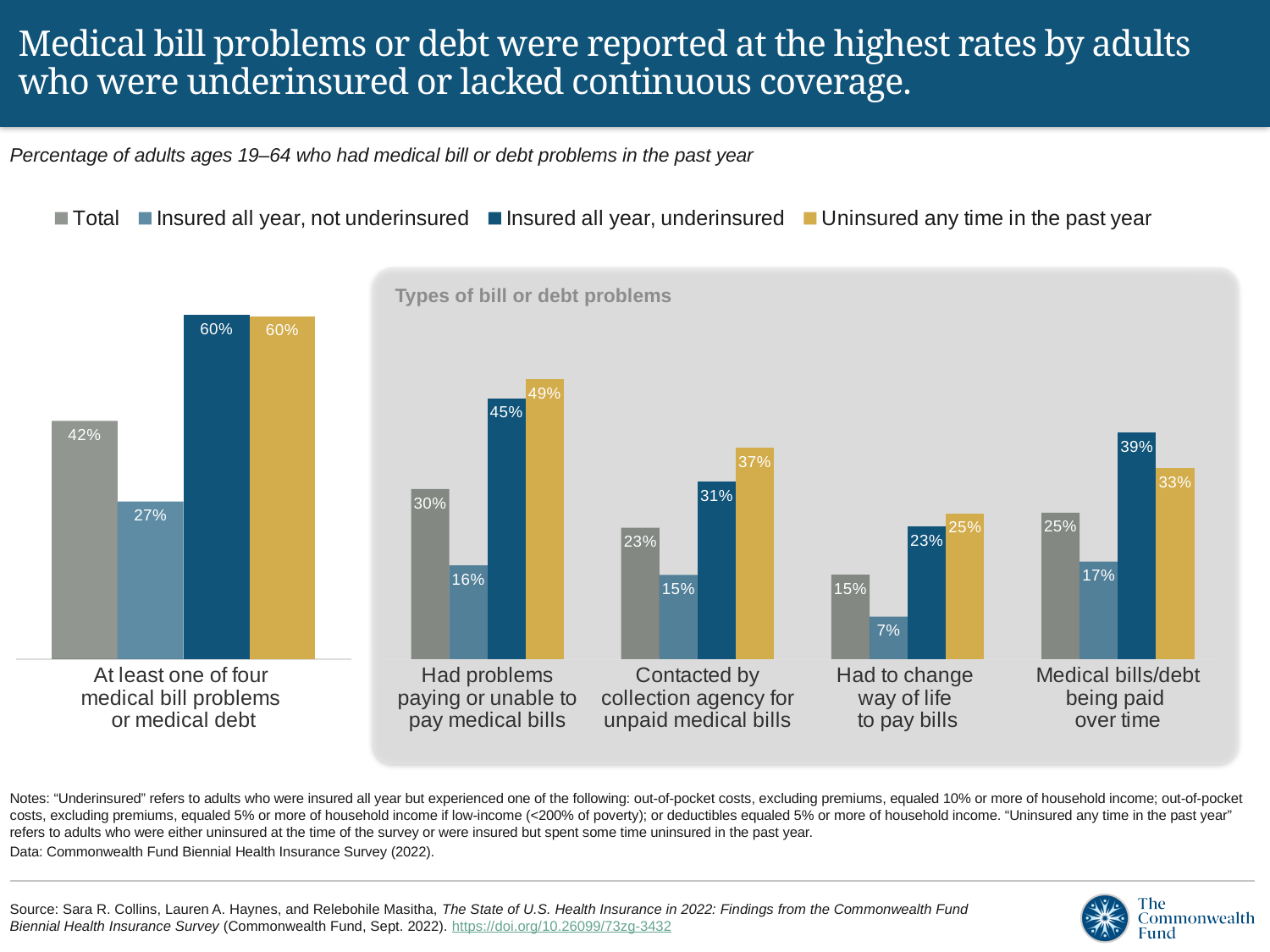
What percentage of adults who were uninsured any time in the past year were contacted by a collection agency for unpaid medical bills? 37% Which category has the highest Total value? At least one of four medical bill problems or medical debt Which category has the lowest value for the 'Insured all year, not underinsured' series? Had to change way of life to pay bills What percentage of adults insured all year, not underinsured had to change their way of life to pay bills? 7% What percentage of adults who were insured all year, underinsured had problems paying or were unable to pay medical bills? 45% How many categories are shown on the x axis of the chart? 5 Which series is shown in gold/yellow in the legend? Uninsured any time in the past year What is the Total value for 'At least one of four medical bill problems or medical debt'? 42% How many series does the legend list? 4 What is the difference between the 'Insured all year, underinsured' and 'Insured all year, not underinsured' values for 'Medical bills/debt being paid over time'? 22 percentage points What kind of chart is shown on the slide? Bar chart For 'Medical bills/debt being paid over time', which is larger: the value for 'Insured all year, underinsured' or 'Uninsured any time in the past year'? Insured all year, underinsured